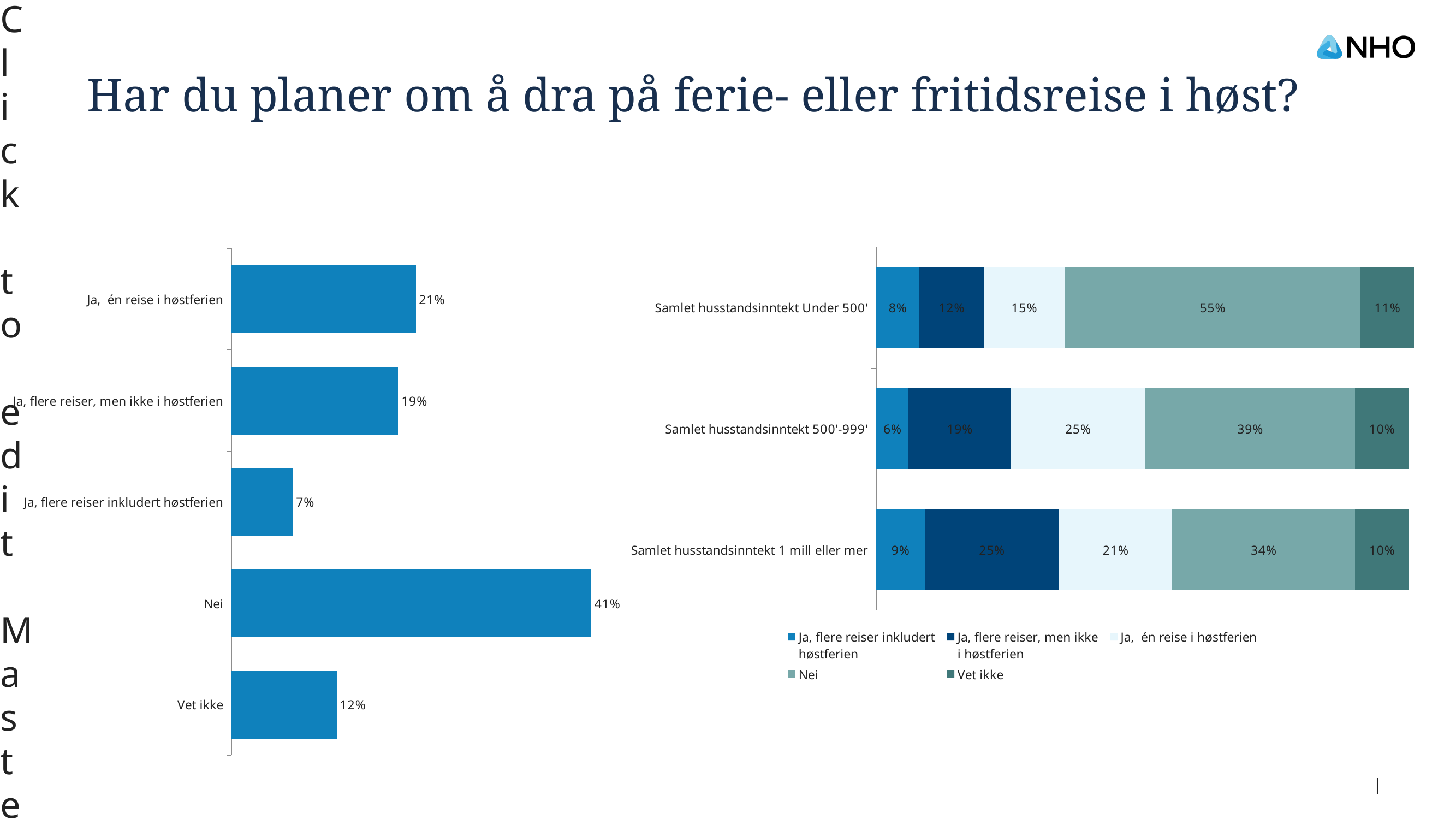
What kind of chart is the left chart? bar chart In the right chart, what is the value for Ja, flere reiser, men ikke i høstferien for Samlet husstandsinntekt 1 mill eller mer? 25% In the left chart, which category has the highest value? Nei How many series does the legend of the right chart list? 5 In the right chart, what is the Nei value for Samlet husstandsinntekt Under 500'? 55% In the left chart, what is the value for Ja, flere reiser inkludert høstferien? 7% In the left chart, what is the difference between the values for Nei and Vet ikke? 29% In the left chart, what is the value for Nei? 41% In the right chart, is the Ja, én reise i høstferien value larger for Samlet husstandsinntekt 500'-999' or for Samlet husstandsinntekt 1 mill eller mer? Samlet husstandsinntekt 500'-999' In the right chart, which income group has the highest Nei value? Samlet husstandsinntekt Under 500' In the left chart, which category has the lowest value? Ja, flere reiser inkludert høstferien In the left chart, how many categories are shown? 5